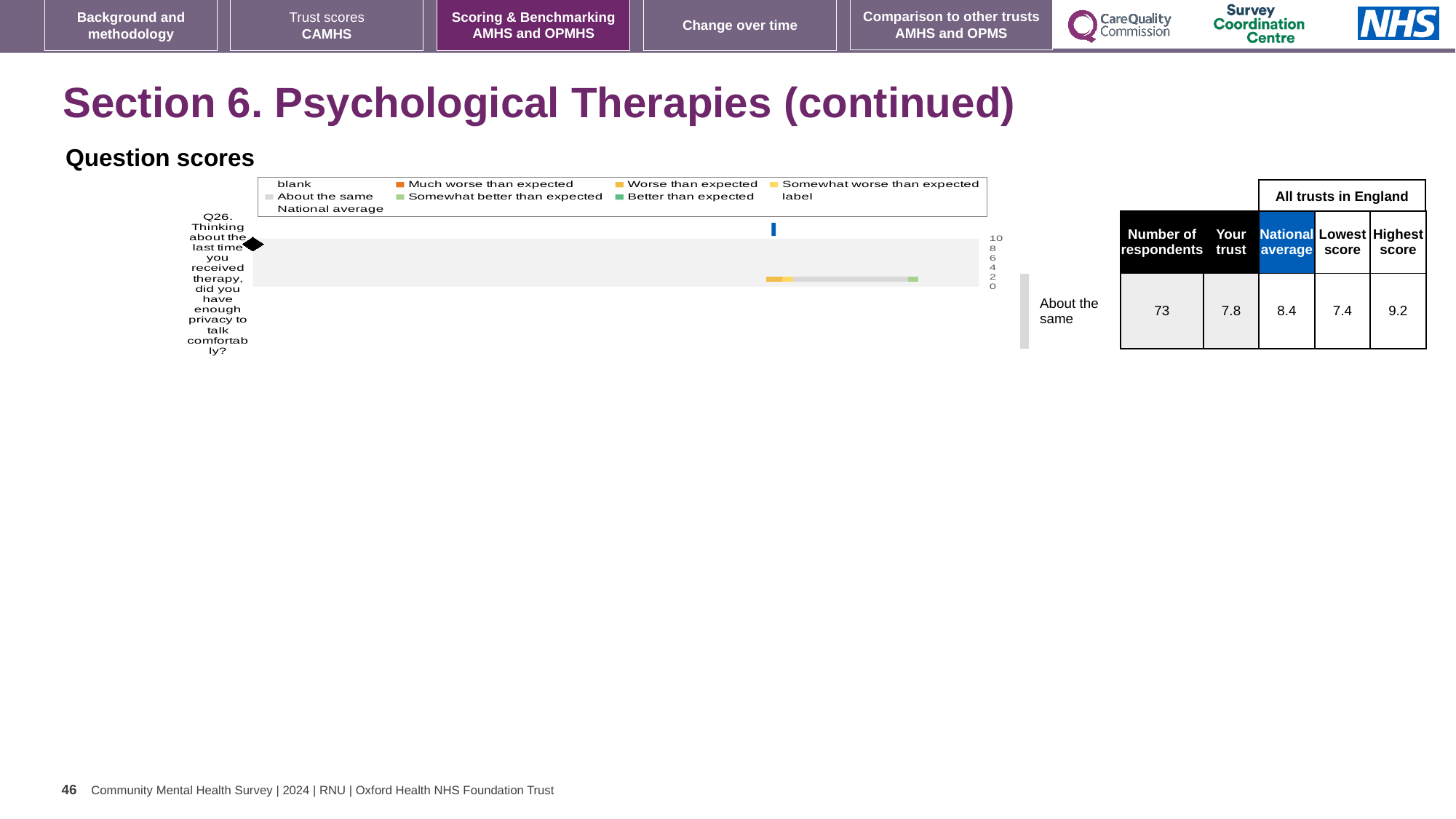
In the table beside the chart, what is the lowest score among all trusts in England for Q26? 7.4 What is the highest value shown on the chart's numeric axis? 10 Which question number is plotted on the chart? Q26 In the table beside the chart, what is the national average score for Q26? 8.4 What kind of chart is shown under 'Question scores'? bar chart How many questions (categories) are plotted on the chart? 1 In the table beside the chart, what is the 'Your trust' score for Q26? 7.8 In the table beside the chart, what is the highest score among all trusts in England for Q26? 9.2 Is the 'Your trust' score for Q26 larger or smaller than the national average? smaller What benchmark category label is shown to the right of the chart for Q26? About the same What is the difference between the highest score and the lowest score for Q26 in the table? 1.8 In the table beside the chart, what is the number of respondents for Q26? 73